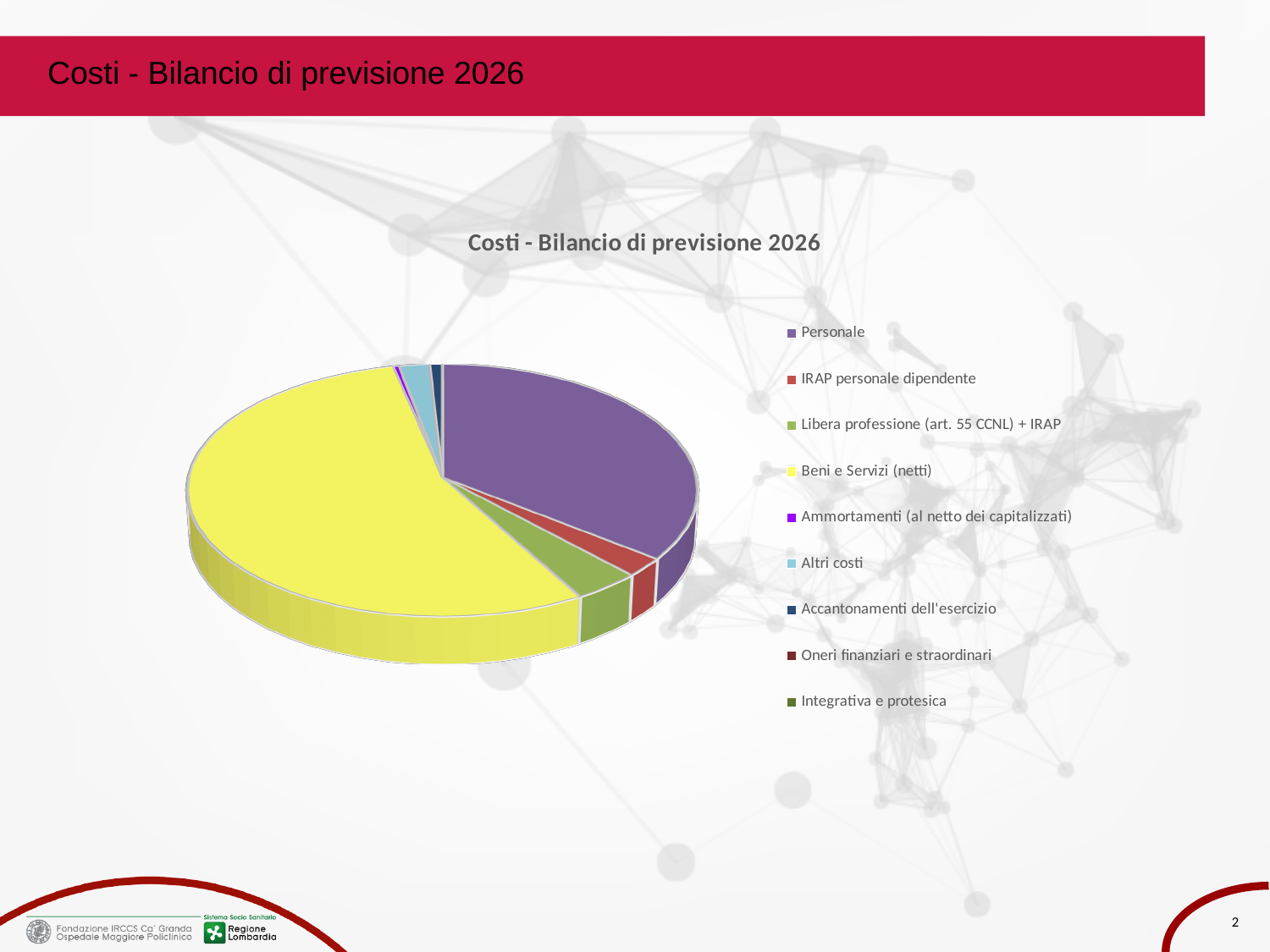
Which slice is larger, Personale or Altri costi? Personale Which slice is larger, Personale or IRAP personale dipendente? Personale Which category is the second-largest slice of the pie? Personale How many entries does the chart's legend list? 9 Which category has the largest slice of the pie? Beni e Servizi (netti) What kind of chart is shown on the slide? Pie chart What is the title of the chart? Costi - Bilancio di previsione 2026 What colour is the slice for Beni e Servizi (netti)? Yellow Which slice is larger, Beni e Servizi (netti) or Personale? Beni e Servizi (netti)